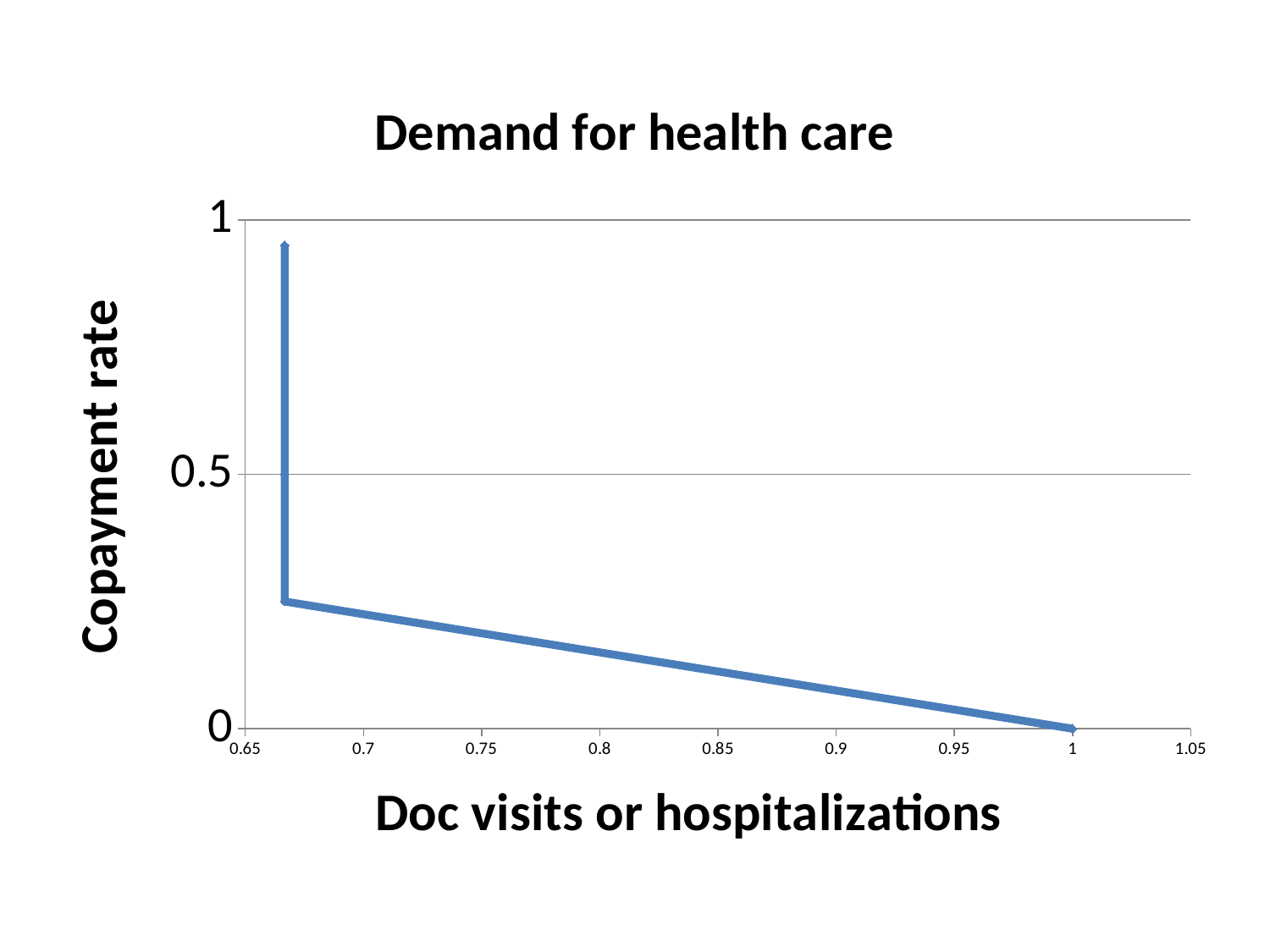
What kind of chart is shown on the slide? line chart What is the label of the vertical axis? Copayment rate Is the copayment rate at the point where the line bends greater or less than 0? greater Is the x-axis value of the topmost point greater or less than 0.7? less Which point has the lowest copayment rate: the one at x = 1 or the one at the top of the vertical segment? the one at x = 1 What is the highest value shown on the x axis? 1.05 Is the copayment rate at the middle plotted point (where the line bends) greater or less than 0.5? less As doc visits or hospitalizations increase along the x axis, does the copayment rate rise or fall? fall What is the copayment rate at the point where doc visits or hospitalizations equal 1? 0 What is the title of the chart? Demand for health care